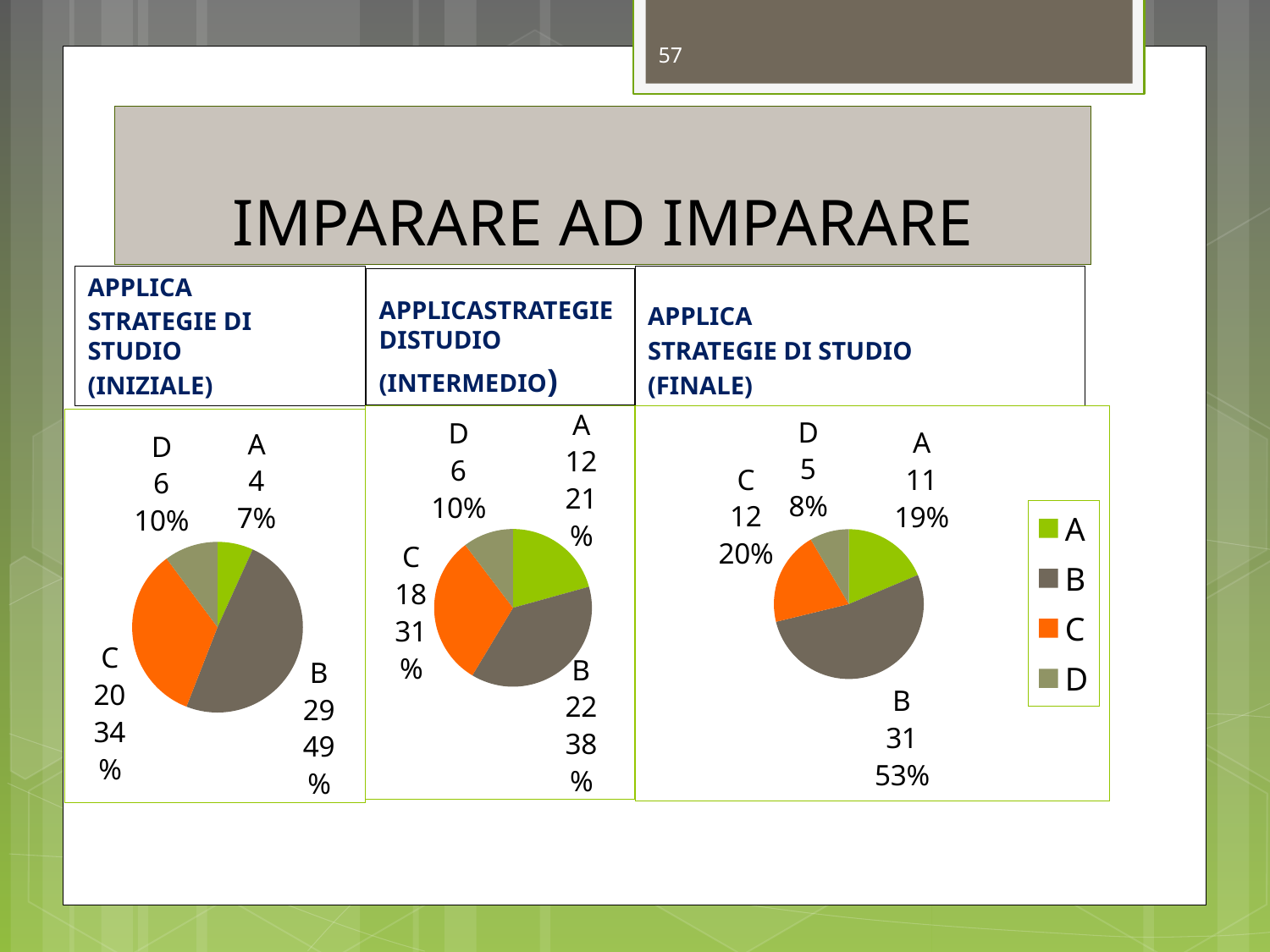
In the FINALE pie chart, which is larger, the share for A or the share for D? A In the INIZIALE pie chart, what is the count shown for category C? 20 In the FINALE pie chart, what is the count shown for category B? 31 How many pie charts are shown on the slide? 3 In the FINALE pie chart, what percentage share does category D have? 8% In the INTERMEDIO pie chart, which category has the largest share? B What kind of chart is used for the INIZIALE, INTERMEDIO and FINALE data? Pie chart In the INIZIALE pie chart, which category has the smallest share? A In the INIZIALE pie chart, what percentage share does category B have? 49% How many categories does the legend on the slide list? 4 In the INTERMEDIO pie chart, what percentage share does category C have? 31% In the INTERMEDIO pie chart, what is the difference between the counts for B and A? 10